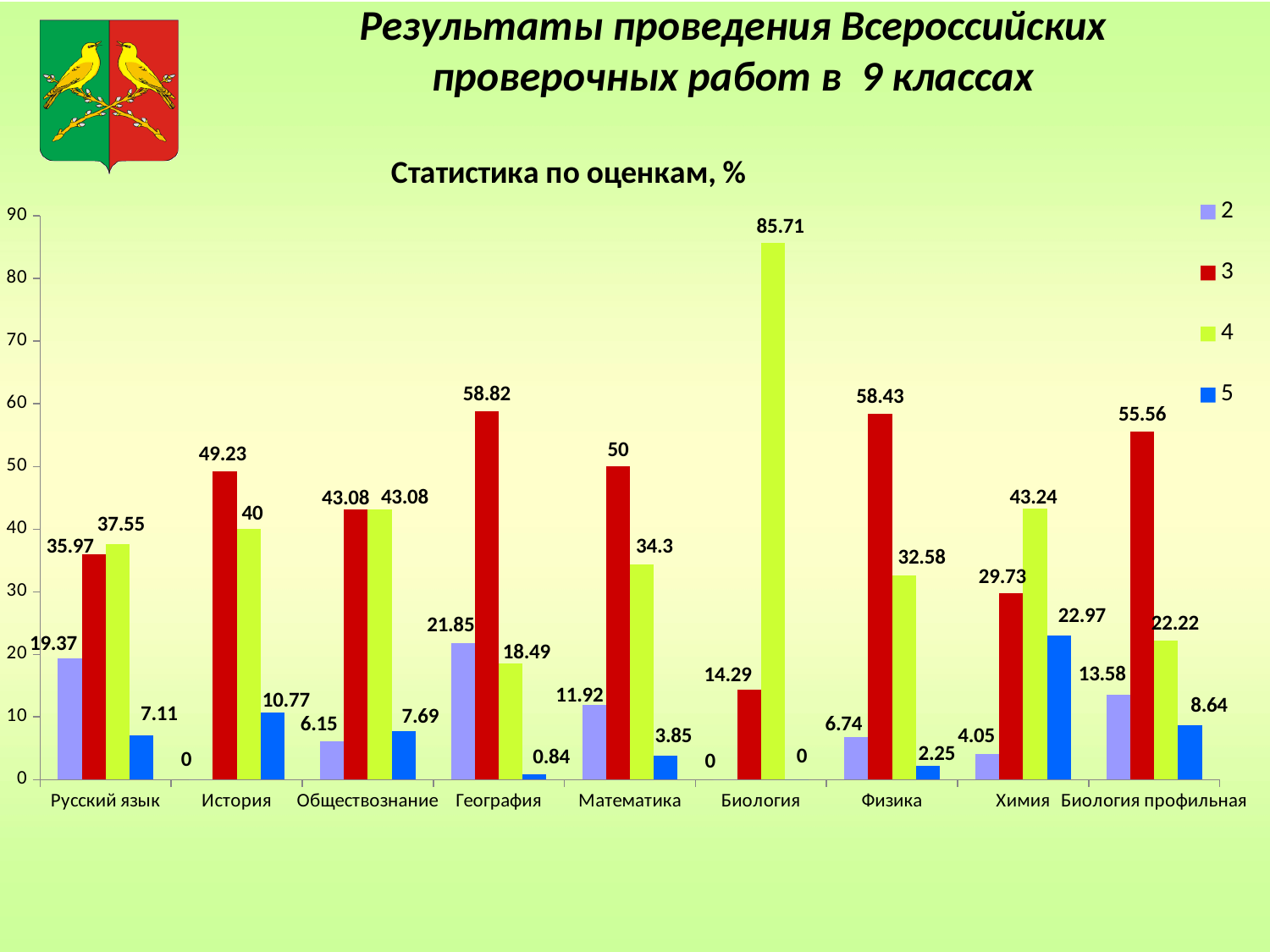
Is the value for grade 3 in Математика greater or less than 40? greater How many subjects are shown on the x axis? 9 Which subject has the highest value for grade 3? География What is the value for grade 3 in География? 58.82 Which subject has the lowest value for grade 5? Биология What is the value for grade 5 in Химия? 22.97 What is the value for grade 4 in Биология? 85.71 How many series does the legend list? 4 What is the difference between the grade 3 and grade 4 values in Физика? 25.85 Which is larger in Химия: the value for grade 4 or the value for grade 3? grade 4 What kind of chart is shown on the slide? bar chart What is the value for grade 2 in Русский язык? 19.37